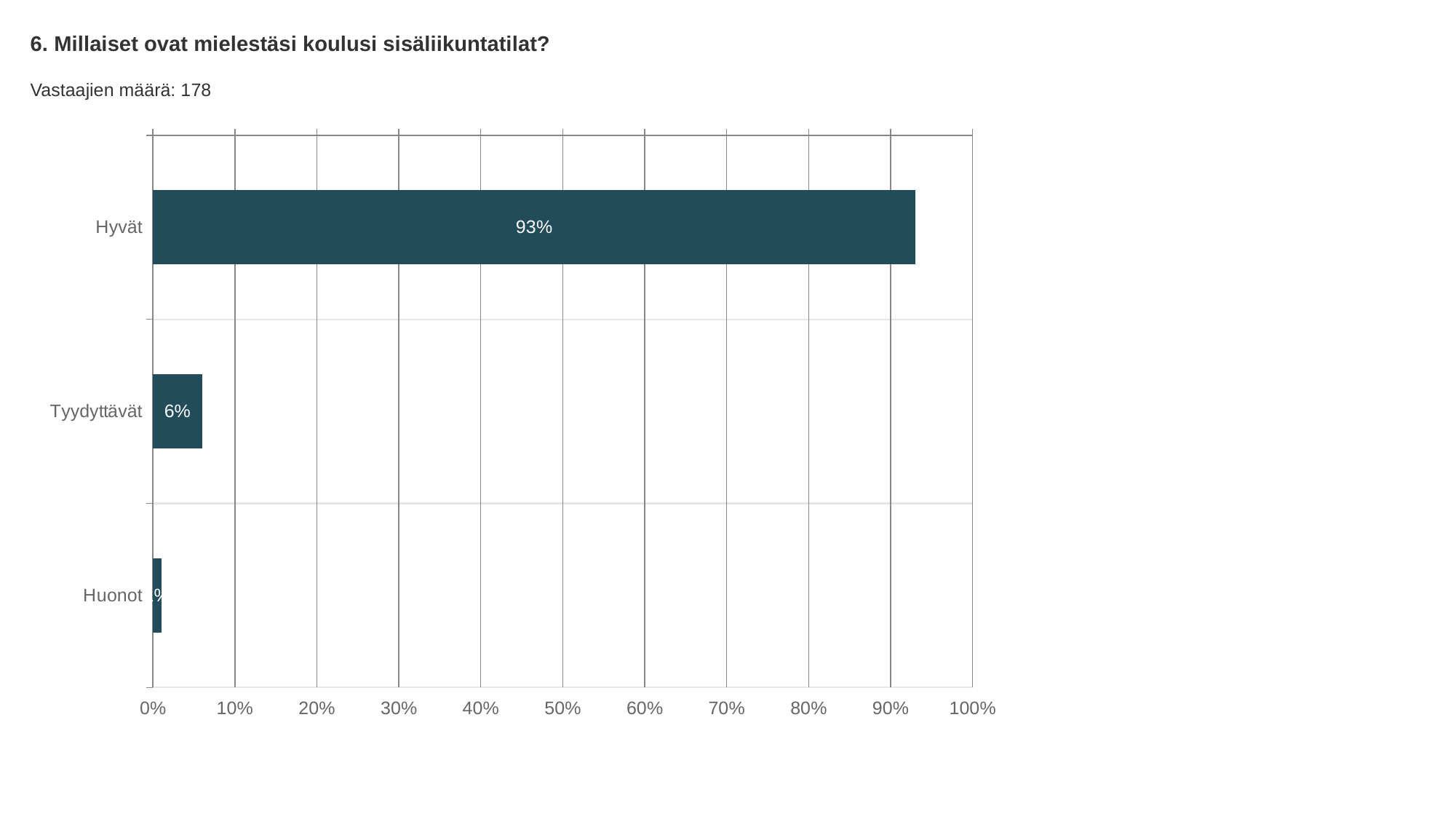
How many categories are shown in the chart? 3 What is the title of the chart? 6. Millaiset ovat mielestäsi koulusi sisäliikuntatilat? Is the value for "Huonot" greater or less than 10%? less Is the value for "Hyvät" greater or less than 90%? greater What kind of chart is shown on the slide? bar chart Which is larger, the value for "Tyydyttävät" or the value for "Huonot"? Tyydyttävät What is the difference between the values for "Hyvät" and "Tyydyttävät"? 87% Which category has the lowest value? Huonot What percentage of respondents answered "Hyvät"? 93% What percentage of respondents answered "Tyydyttävät"? 6% Which category has the highest value? Hyvät How many respondents (Vastaajien määrä) does the slide report? 178